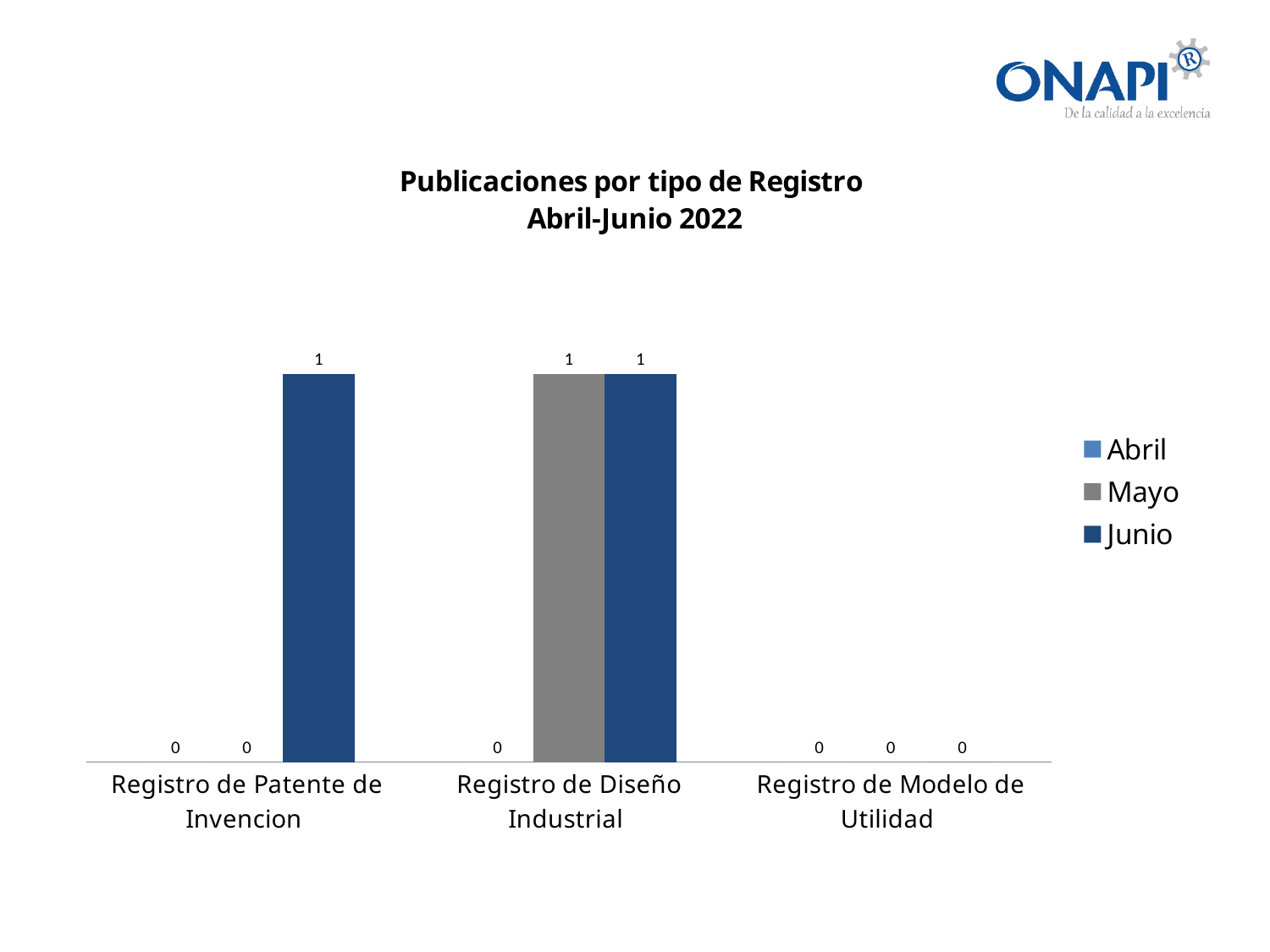
What is the title of the chart? Publicaciones por tipo de Registro Abril-Junio 2022 How many series does the legend list? 3 How many categories are shown on the x axis? 3 What is the difference between the Junio value and the Abril value for Registro de Patente de Invencion? 1 What is the value for Junio in the Registro de Patente de Invencion category? 1 What is the value for Junio in the Registro de Modelo de Utilidad category? 0 What is the value for Mayo in the Registro de Diseño Industrial category? 1 What is the value for Abril in the Registro de Diseño Industrial category? 0 What is the value for Mayo in the Registro de Patente de Invencion category? 0 What is the total of the Abril, Mayo and Junio values for Registro de Diseño Industrial? 2 Which is larger for Registro de Diseño Industrial: the Mayo value or the Abril value? Mayo What kind of chart is shown on the slide? Bar chart